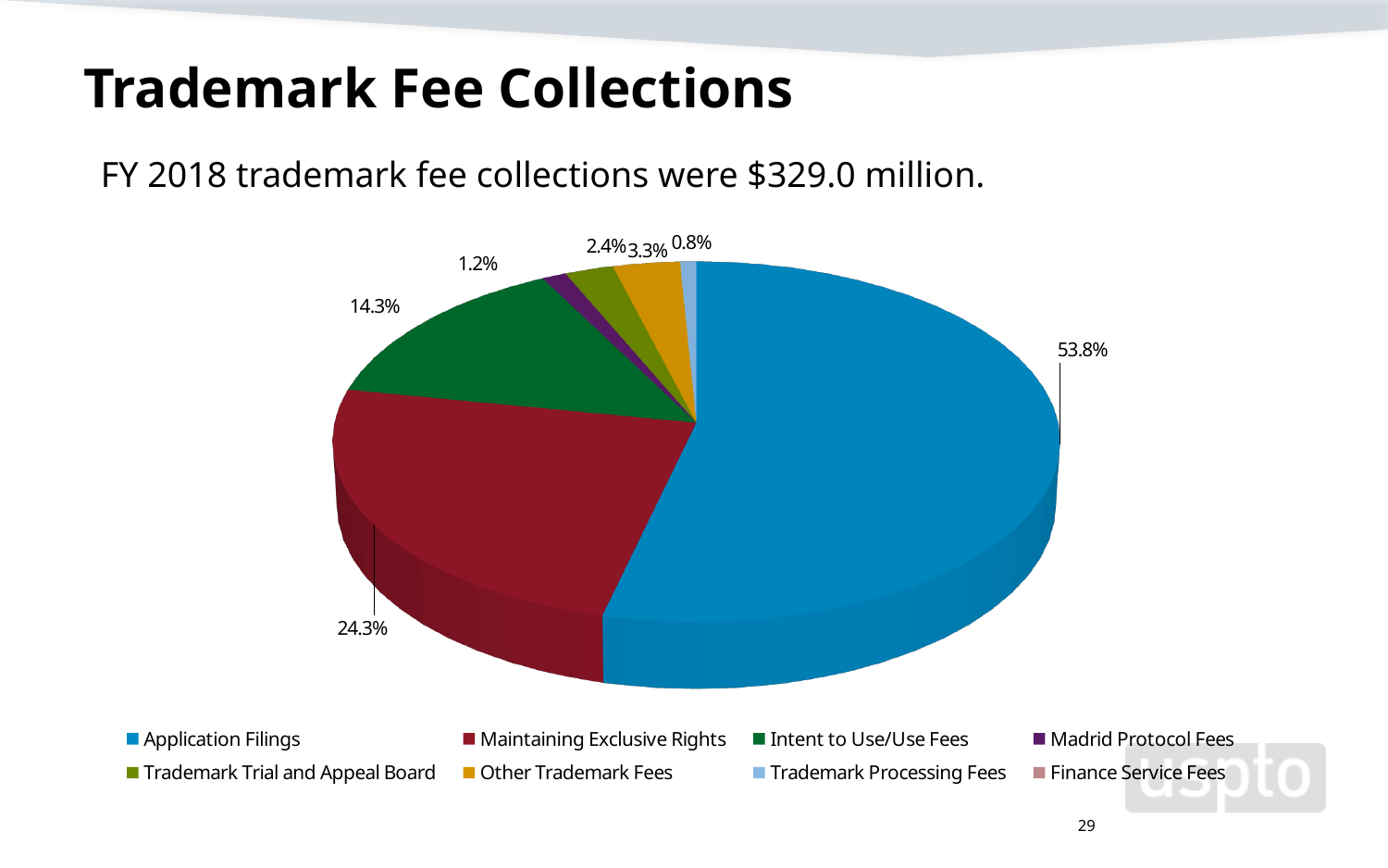
What percentage of the pie is Maintaining Exclusive Rights? 24.3% What is the combined share of Application Filings and Maintaining Exclusive Rights? 78.1% Which is larger: the share for Intent to Use/Use Fees or the share for Other Trademark Fees? Intent to Use/Use Fees What type of chart is shown on the slide? Pie chart What share of collections is Other Trademark Fees? 3.3% What percentage is shown for Trademark Trial and Appeal Board? 2.4% What percentage is labeled for Madrid Protocol Fees? 1.2% Which category accounts for the largest share of trademark fee collections? Application Filings What share is shown for Intent to Use/Use Fees? 14.3% How many percentage points larger is the Application Filings share than the Maintaining Exclusive Rights share? 29.5 percentage points What share of trademark fee collections comes from Application Filings? 53.8% How many categories does the legend list? 8